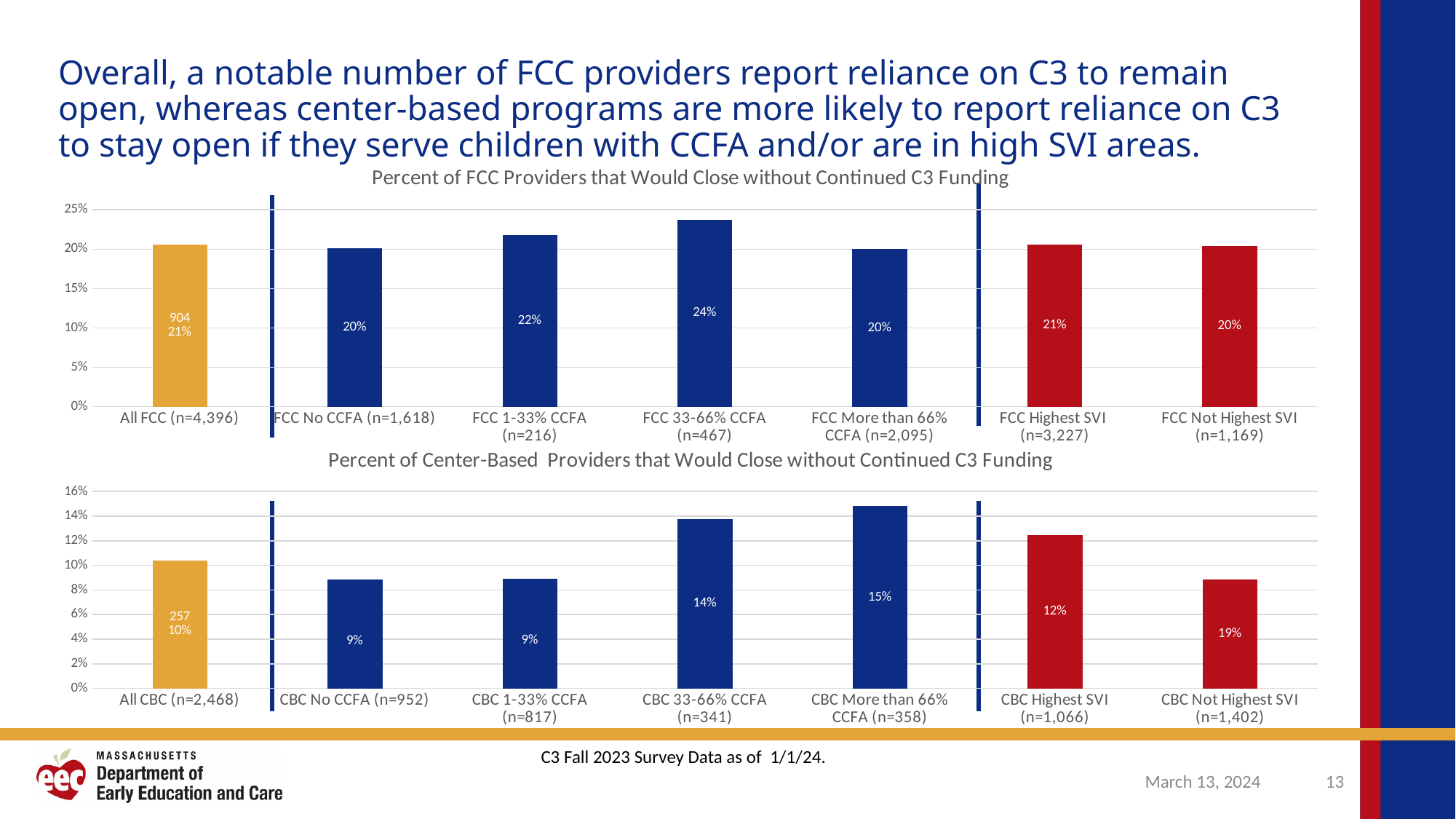
In the bottom chart, which category has the highest percentage? CBC More than 66% CCFA (n=358) In the top chart, what is the value for FCC Highest SVI (n=3,227)? 21% In the top chart, what number is printed on the All FCC bar above the percentage? 904 In the bottom chart, what percent of CBC More than 66% CCFA providers would close without continued C3 funding? 15% In the bottom chart, what is the value for CBC Highest SVI (n=1,066)? 12% In the bottom chart, which is larger: CBC 33-66% CCFA or CBC No CCFA? CBC 33-66% CCFA In the top chart, what percent of FCC 33-66% CCFA providers would close without continued C3 funding? 24% What type of chart is the bottom chart? Bar chart How many categories are shown in the top chart? 7 In the top chart, what is the difference between FCC 33-66% CCFA and FCC No CCFA? 4% In the bottom chart, is the value for All CBC greater or less than 8%? greater In the top chart, which category has the highest percentage? FCC 33-66% CCFA (n=467)